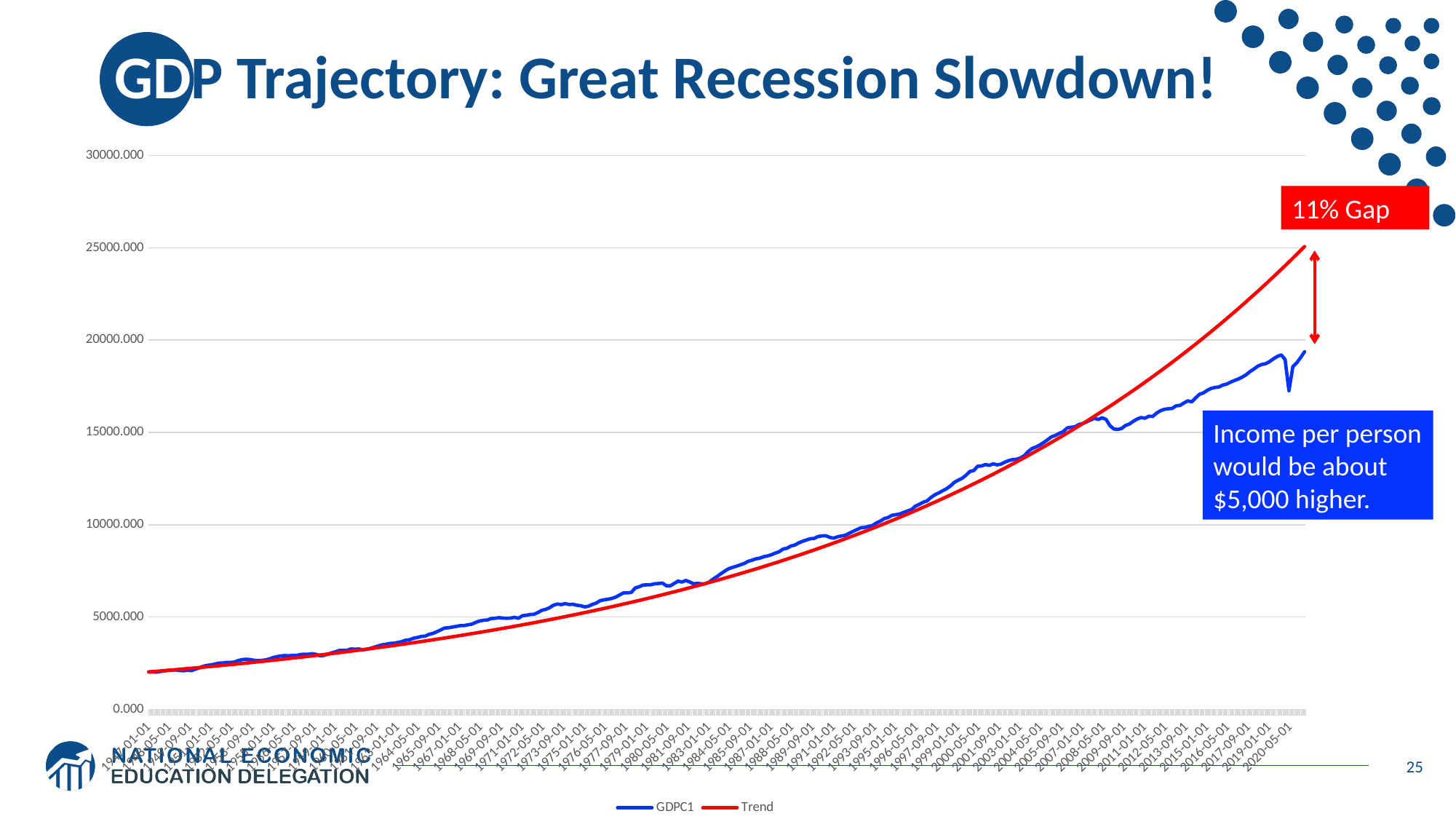
At the right end of the chart, which series has the higher value, GDPC1 or Trend? Trend What are the names of the two series in the legend? GDPC1 and Trend What percentage gap between the Trend line and GDPC1 is annotated on the chart? 11% Gap At the right end of the chart, is the GDPC1 value greater or less than 20000.000? less At the left end of the chart (1947), is the GDPC1 value greater or less than 5000.000? less Do the GDPC1 values generally rise or fall from left to right along the x axis? rise At the right end of the chart, is the Trend value greater or less than 20000.000? greater What colour is the Trend line? red What is the highest value shown on the y axis? 30000.000 What kind of chart is shown on the slide? line chart How many series does the legend list? 2